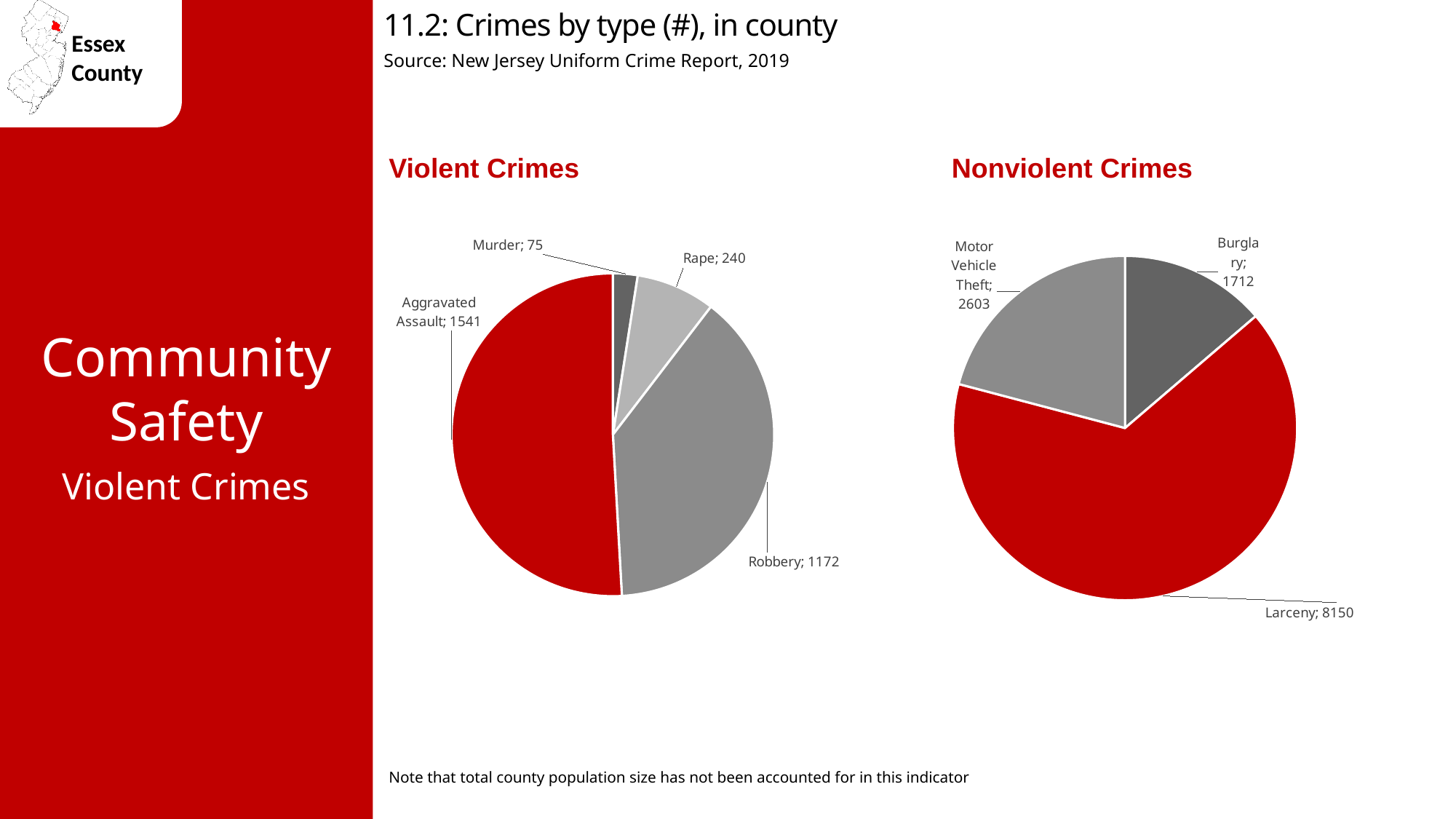
What type of chart is used for Nonviolent Crimes? Pie chart How many categories are shown in the Violent Crimes pie chart? 4 How many categories are shown in the Nonviolent Crimes pie chart? 3 In the Violent Crimes pie chart, which category has the smallest value? Murder In the Nonviolent Crimes pie chart, which category has the smallest value? Burglary In the Violent Crimes pie chart, which is larger, Rape or Robbery? Robbery In the Nonviolent Crimes pie chart, what is the value for Motor Vehicle Theft? 2603 In the Violent Crimes pie chart, which category has the largest value? Aggravated Assault In the Nonviolent Crimes pie chart, how much larger is Larceny than Motor Vehicle Theft? 5547 In the Violent Crimes pie chart, how many murders are shown? 75 What is the total of all categories in the Nonviolent Crimes pie chart? 12465 In the Violent Crimes pie chart, what is the difference between Aggravated Assault and Robbery? 369